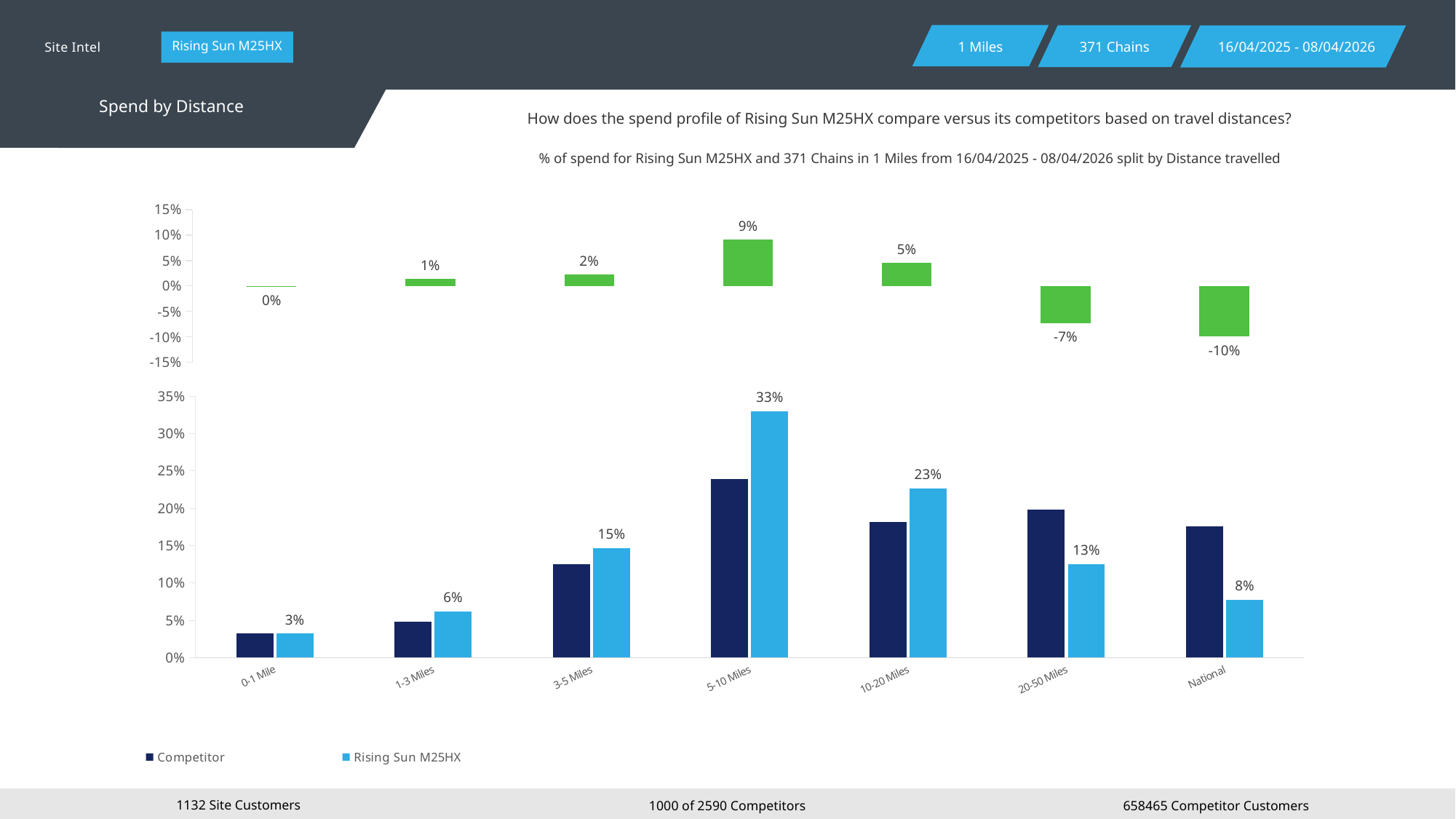
In the bottom chart, is the Competitor value at 10-20 Miles greater or less than 20%? less In the bottom chart, at 20-50 Miles, which series has the larger value, Competitor or Rising Sun M25HX? Competitor In the bottom chart, is the Competitor value at 5-10 Miles greater or less than 20%? greater In the bottom chart, what is the value for Rising Sun M25HX at 5-10 Miles? 33% How many distance bands are shown on the x axis of the bottom chart? 7 In the bottom chart, what is the difference between the Rising Sun M25HX values at 5-10 Miles and 10-20 Miles? 10% In the bottom chart, which distance band has the lowest value for Rising Sun M25HX? 0-1 Mile In the top chart, what is the value of the rightmost bar? -10% How many series does the legend of the bottom chart list? 2 In the bottom chart, which distance band has the highest value for Rising Sun M25HX? 5-10 Miles What type of chart is the bottom chart? bar chart In the bottom chart, what is the value for Rising Sun M25HX at National? 8%